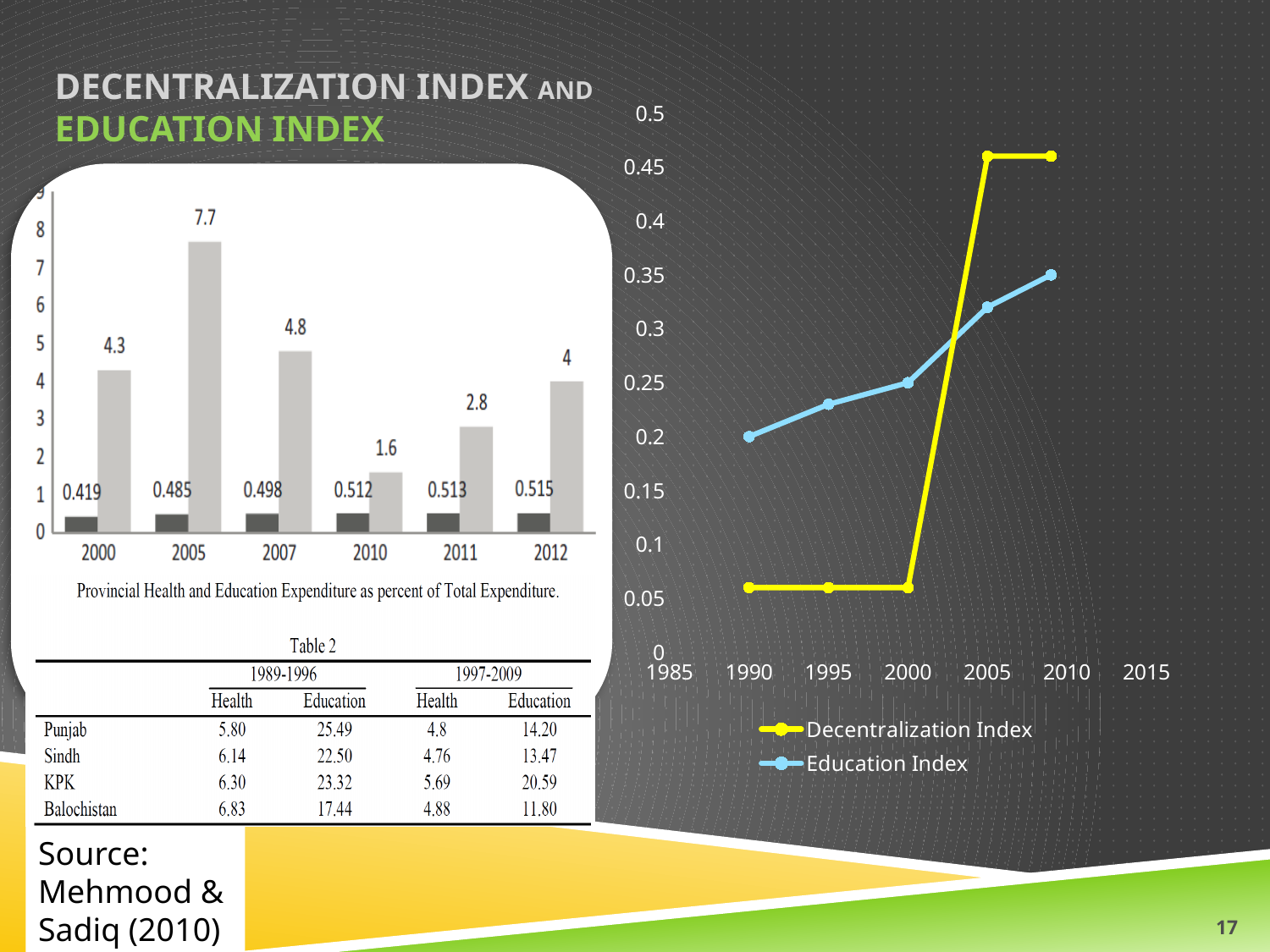
On the left bar chart, what is the value of the light grey bar for 2010? 1.6 On the left bar chart, which year has the lowest light grey bar? 2010 On the right line chart, does the Education Index rise or fall from 1990 to 2010? rise On the left bar chart, which year has the highest light grey bar? 2005 On the left bar chart, what is the difference between the light grey bar values for 2005 and 2007? 2.9 How many years are shown on the x axis of the left bar chart? 6 On the left bar chart, is the light grey bar for 2012 larger or smaller than the one for 2011? larger How many series does the legend of the right line chart list? 2 On the left bar chart, what is the value of the tall light grey bar for 2005? 7.7 On the left bar chart, what is the value printed for the dark bar in 2000? 0.419 What kind of chart is the chart on the right side of the slide? line chart On the right line chart, is the Decentralization Index value for 2005 greater or less than 0.4? greater